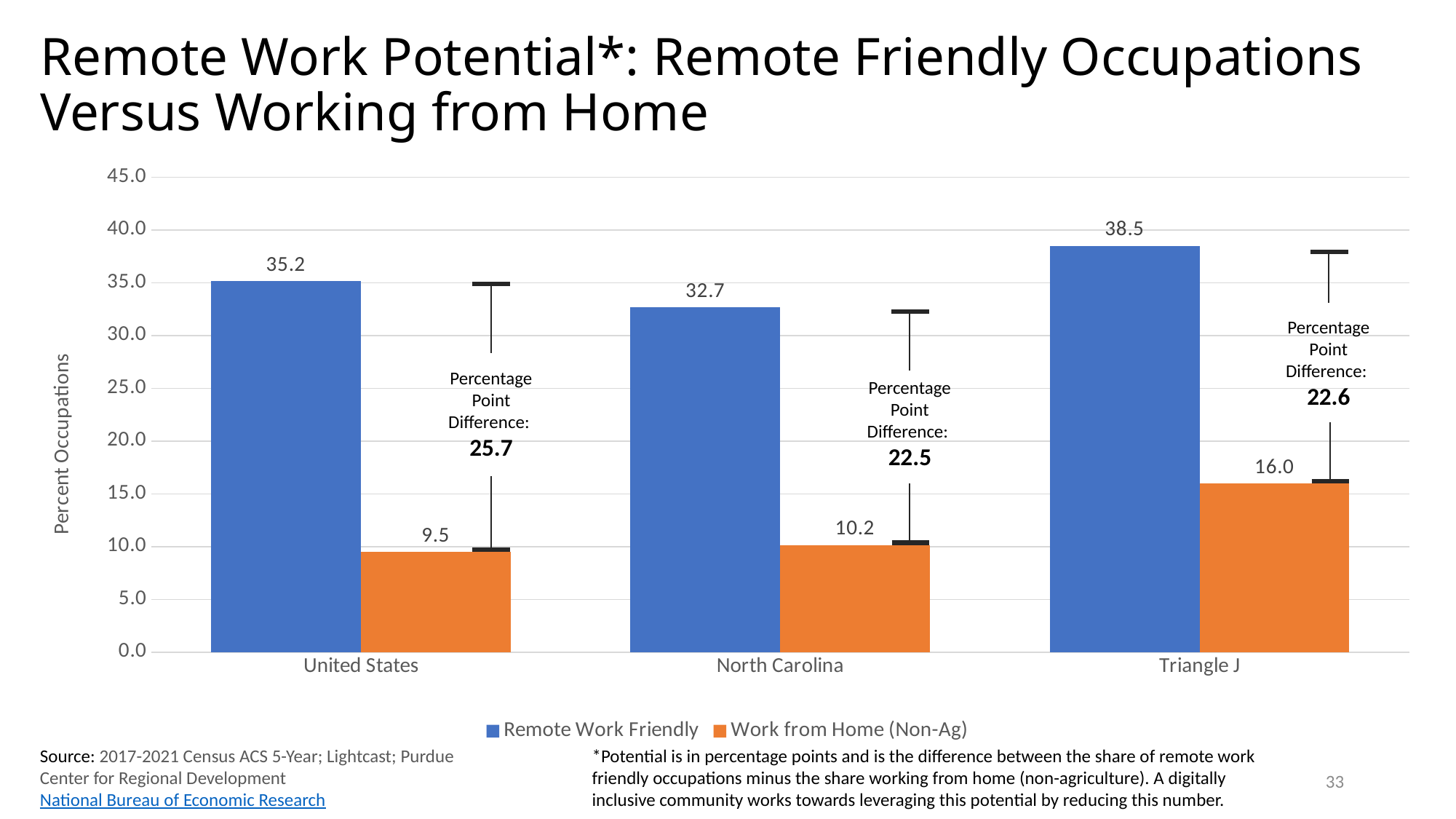
Is the Remote Work Friendly value for Triangle J greater or less than 35.0? greater What is the difference between the Remote Work Friendly and Work from Home (Non-Ag) values for North Carolina? 22.5 What is the label of the y axis? Percent Occupations What is the Work from Home (Non-Ag) value for North Carolina? 10.2 Which is larger: the Remote Work Friendly value for the United States or for North Carolina? United States How many series does the legend list? 2 What kind of chart is shown on the slide? Bar chart Which region has the highest Remote Work Friendly value? Triangle J What is the Remote Work Friendly value for the United States? 35.2 How many regions are shown on the x axis? 3 Which region has the lowest Work from Home (Non-Ag) value? United States What is the Work from Home (Non-Ag) value for Triangle J? 16.0